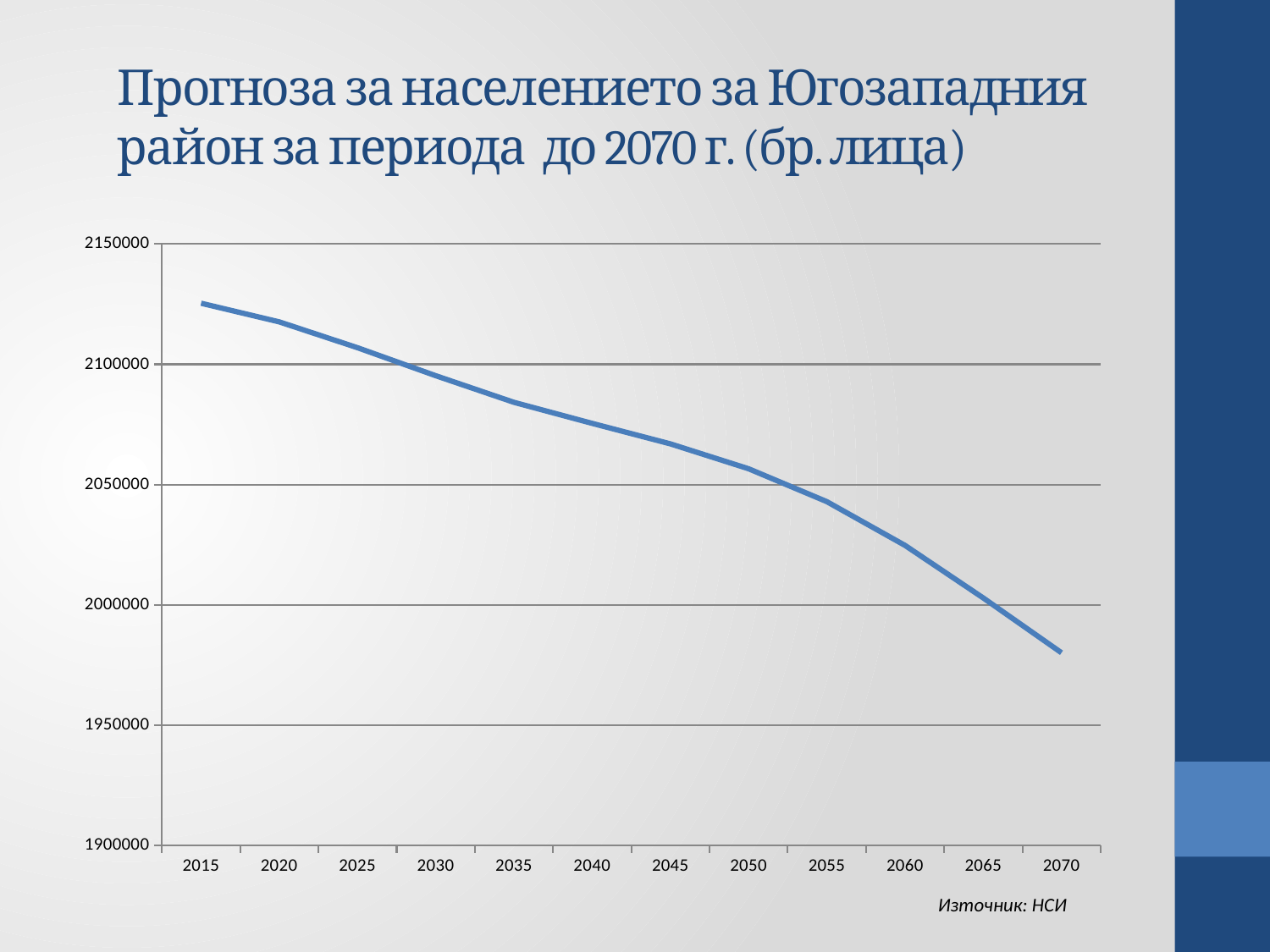
Which year has the lowest projected population? 2070 Is the value for 2015 greater or less than 2100000? greater How many years are marked on the x axis of the chart? 12 Which year has the highest projected population? 2015 Is the value for 2060 greater or less than 2000000? greater What kind of chart is shown on the slide? line chart Is the value for 2030 greater or less than 2100000? less What source is cited below the chart? НСИ Does the projected population rise or fall from 2015 to 2070? fall Which year has the larger projected population, 2020 or 2045? 2020